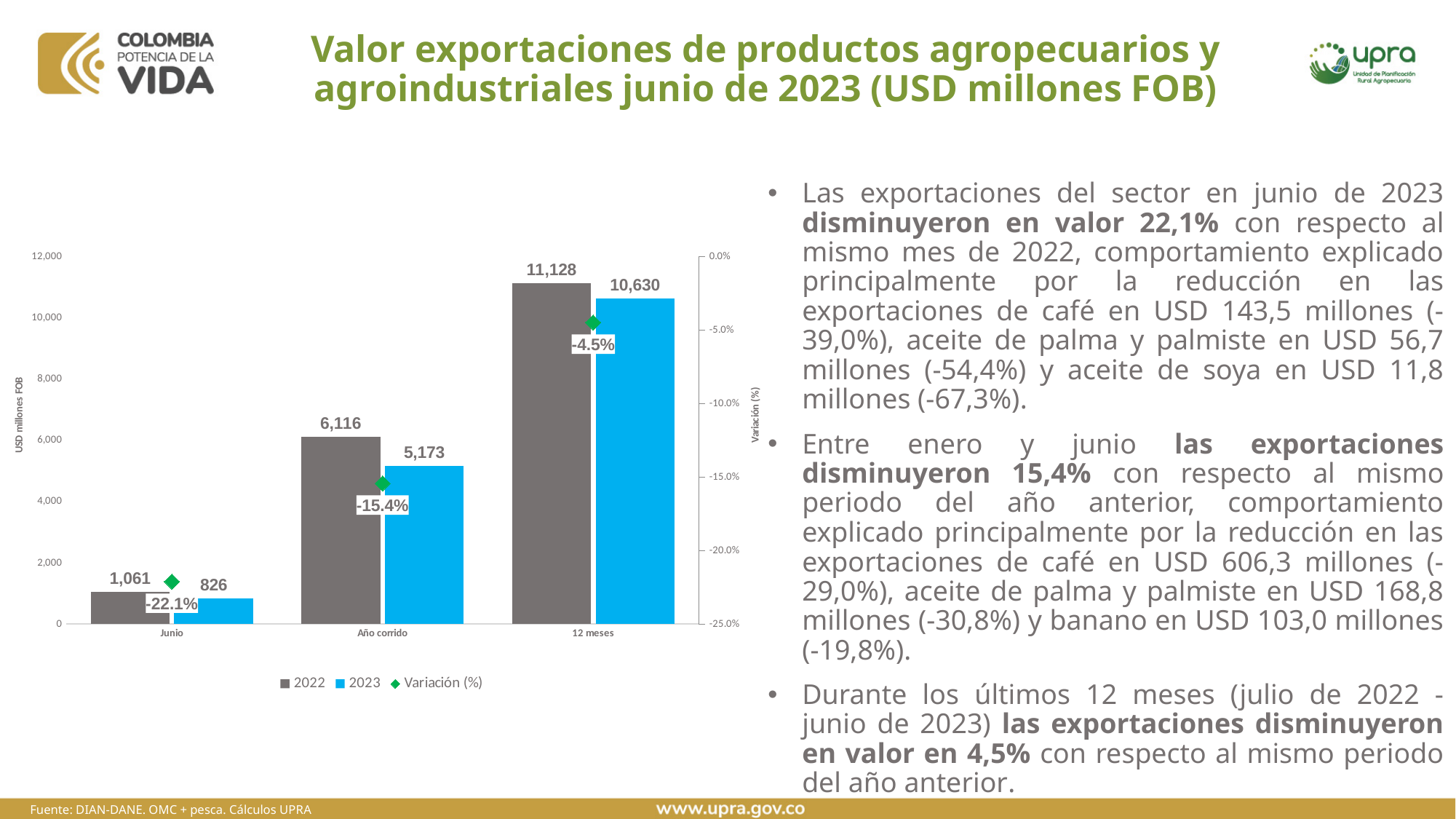
What is the 2023 value for Año corrido? 5,173 What is the difference between the 2022 and 2023 values for Año corrido? 943 Which is larger for Junio, the 2022 value or the 2023 value? 2022 What is the label of the left vertical axis? USD millones FOB How many series does the legend list? 3 Which category has the highest 2022 value? 12 meses What is the 2023 value for 12 meses? 10,630 What is the 2022 value for Junio? 1,061 What is the Variación (%) for 12 meses? -4.5% How many categories are shown on the x axis? 3 Which category has the lowest 2023 value? Junio What kind of chart is shown on the slide? Bar chart with a line/marker series